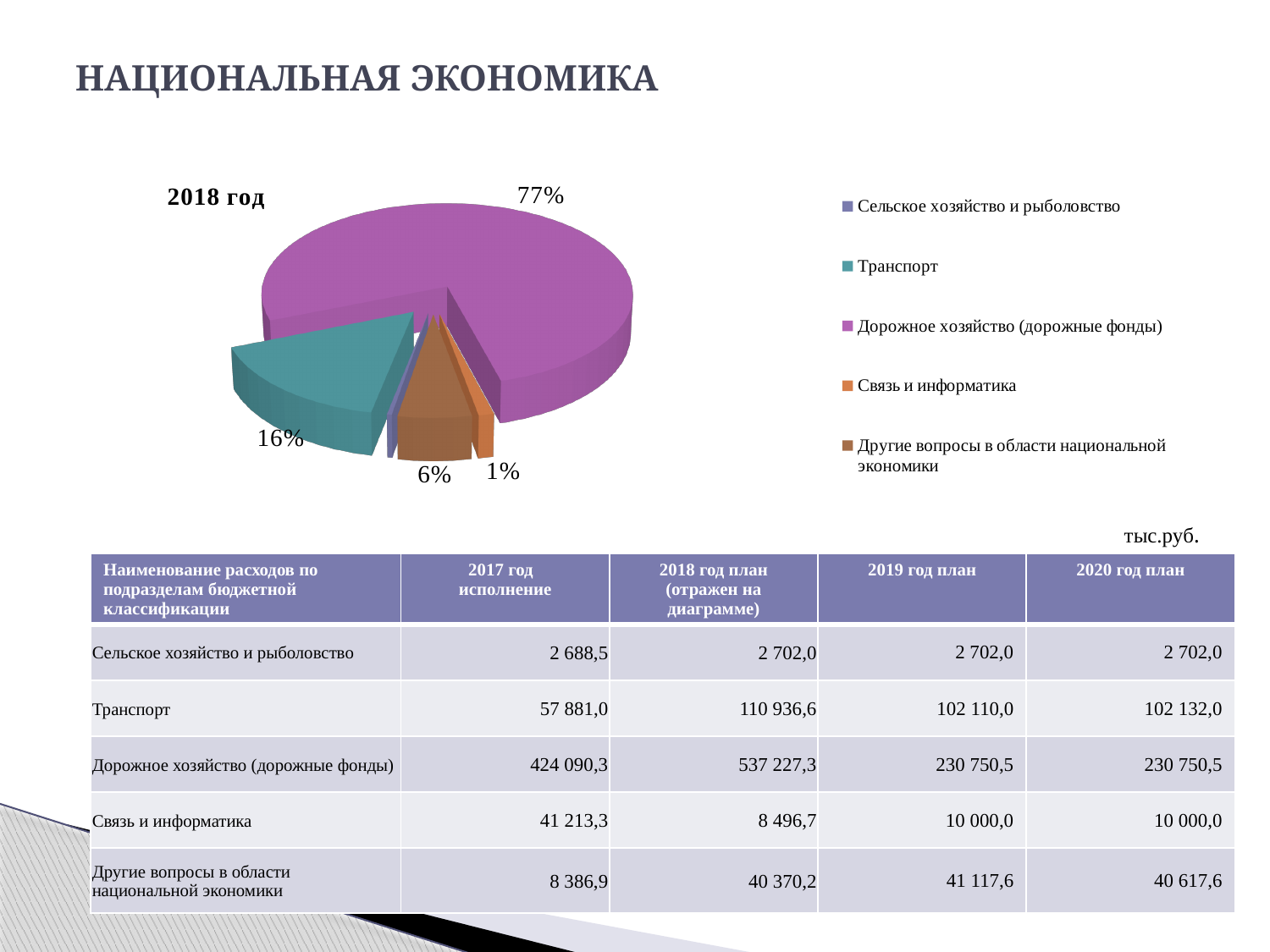
Which is larger in the pie chart, the slice for Транспорт or the slice for Связь и информатика? Транспорт Which is larger in the pie chart, the slice for Другие вопросы в области национальной экономики or the slice for Связь и информатика? Другие вопросы в области национальной экономики What is the title of the pie chart? 2018 год What share of the pie does Транспорт have? 16% What share of the pie does Дорожное хозяйство (дорожные фонды) have? 77% What colour is the largest slice of the pie chart? purple How many entries does the legend of the pie chart list? 5 What share of the pie does Связь и информатика have? 1% Which category has the largest slice of the pie? Дорожное хозяйство (дорожные фонды) What is the difference in percentage points between the Дорожное хозяйство (дорожные фонды) slice and the Транспорт slice? 61% What kind of chart is shown on the slide? pie chart